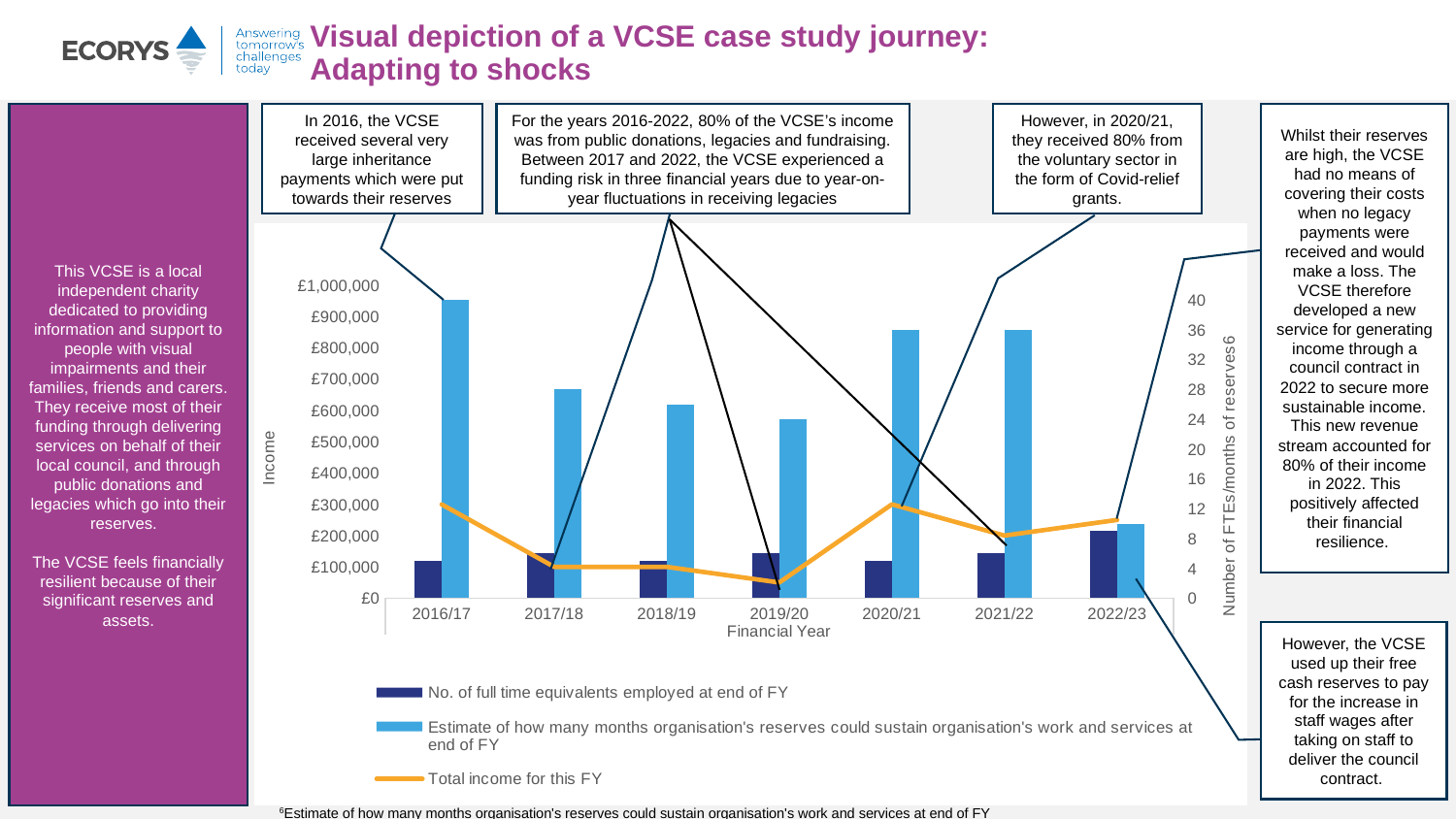
In which financial year is the total income for the FY lowest? 2019/20 In which financial year is the estimate of how many months the organisation's reserves could sustain its work highest? 2016/17 Which year has the larger estimate of months of reserves, 2017/18 or 2020/21? 2020/21 What is the title of the x axis of the chart? Financial Year How many series does the chart's legend list? 3 What kind of chart is shown on the slide? Combined bar and line chart Is the total income for 2019/20 greater or less than £100,000? less In which financial year is the number of full time equivalents employed at end of FY highest? 2022/23 Does the total income for the FY rise or fall from 2016/17 to 2019/20? fall Is the estimate of months of reserves for 2016/17 greater or less than 32? greater How many financial years are shown on the x axis of the chart? 7 In which financial year is the estimate of how many months the organisation's reserves could sustain its work lowest? 2022/23